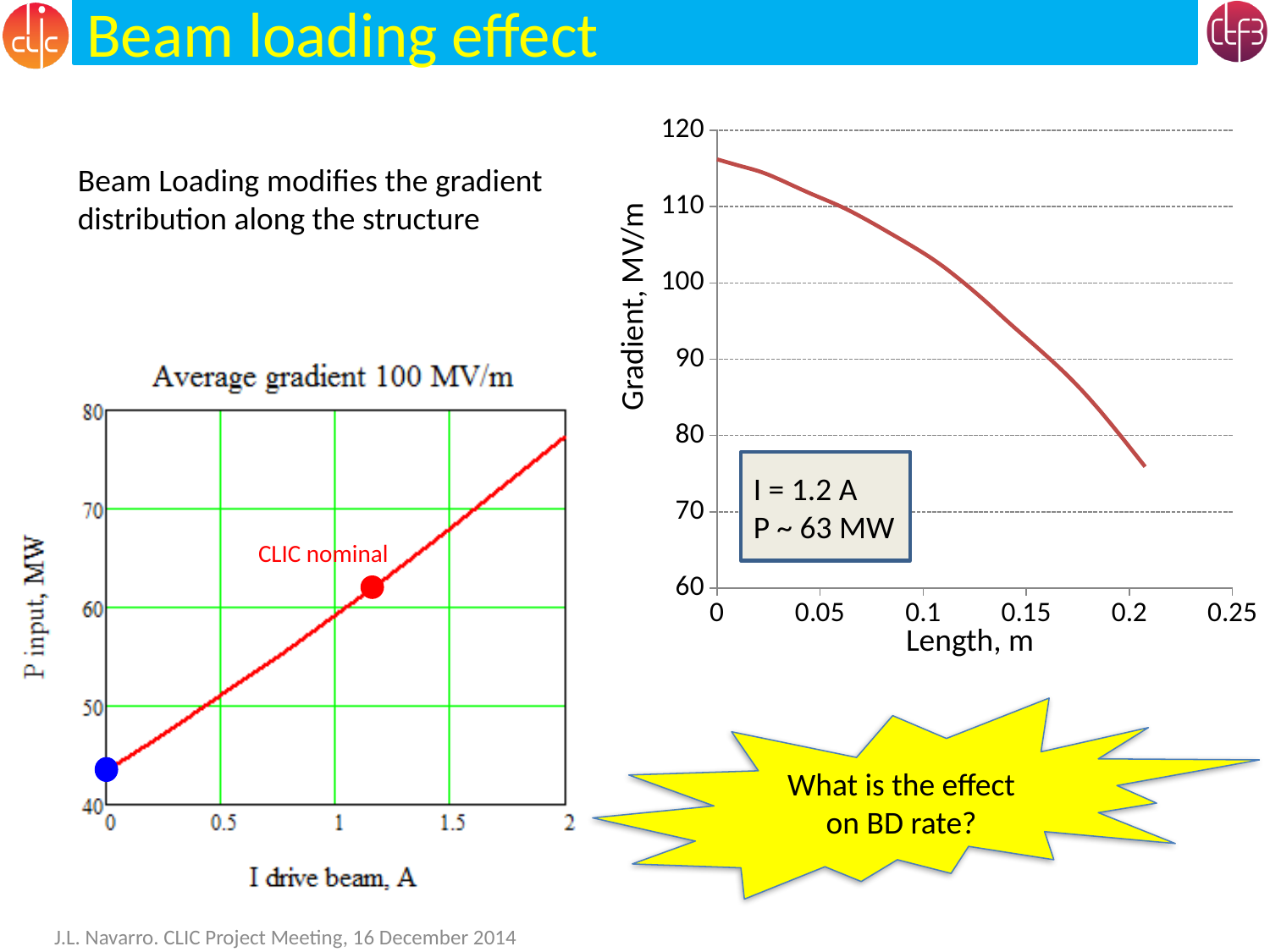
On the right chart of Gradient versus Length, is the gradient at length 0.2 m greater or less than 90 MV/m? less On the right chart of Gradient versus Length, what kind of chart is it? line chart On the left chart titled 'Average gradient 100 MV/m', what kind of chart is it? line chart On the left chart titled 'Average gradient 100 MV/m', is the P input value at I drive beam = 0 A greater or less than 50 MW? less On the left chart titled 'Average gradient 100 MV/m', does P input rise or fall as I drive beam increases? rise On the left chart titled 'Average gradient 100 MV/m', is the P input at the point labelled 'CLIC nominal' greater or less than 60 MW? greater On the right chart of Gradient versus Length, what is the label of the y axis? Gradient, MV/m On the left chart titled 'Average gradient 100 MV/m', what is the label of the x axis? I drive beam, A On the right chart of Gradient versus Length, does the gradient rise or fall as length increases? fall